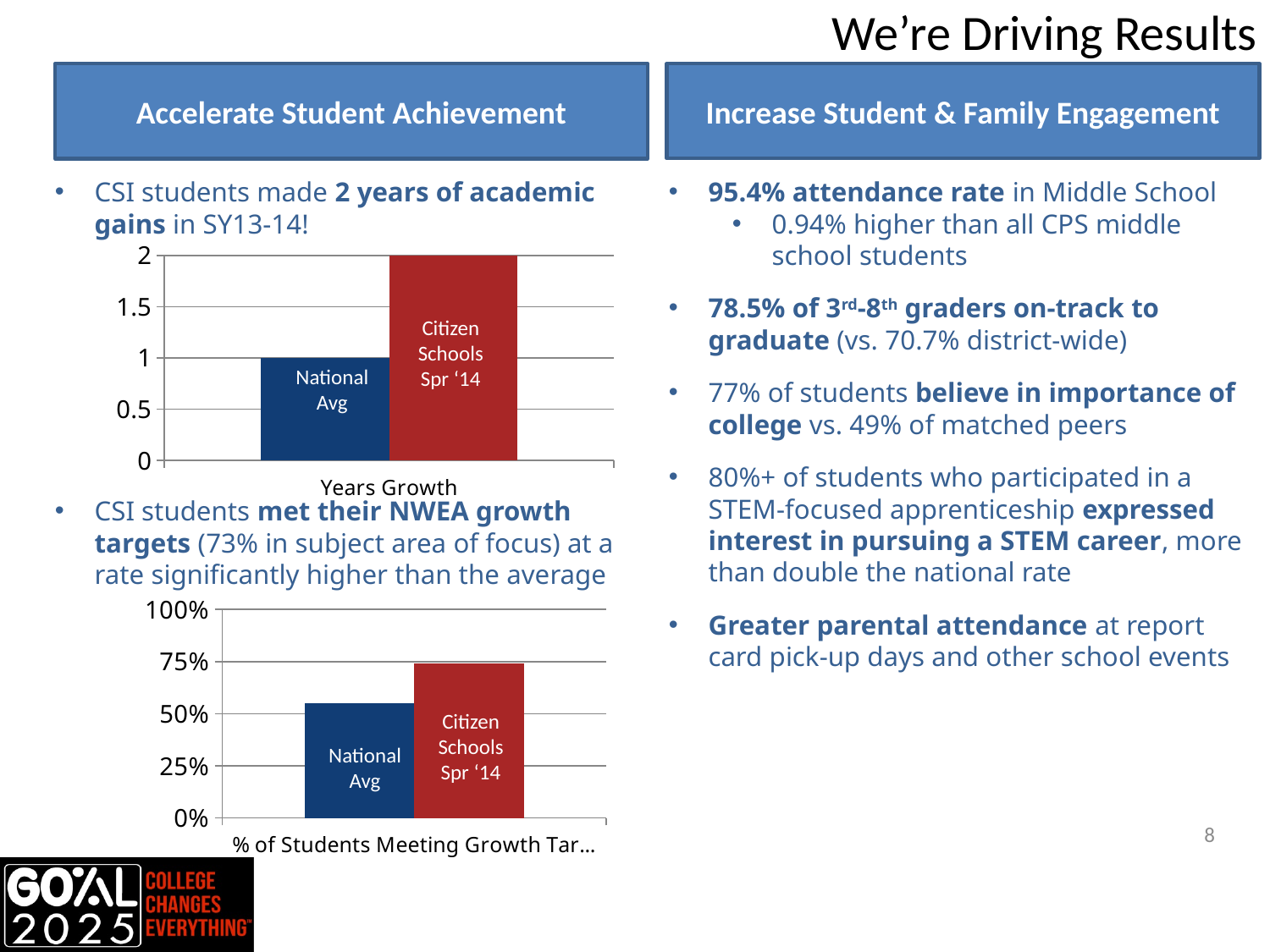
In the % of Students Meeting Growth Targets chart, is the value for Citizen Schools Spr '14 greater or less than 50%? greater In the Years Growth chart, which bar is lowest? National Avg What kind of chart is the Years Growth chart? bar chart In the % of Students Meeting Growth Targets chart, which bar is higher, National Avg or Citizen Schools Spr '14? Citizen Schools Spr '14 In the Years Growth chart, what is the difference between Citizen Schools Spr '14 and National Avg? 1 In the % of Students Meeting Growth Targets chart, what is the highest value shown on the y axis? 100% In the % of Students Meeting Growth Targets chart, is the value for National Avg greater or less than 50%? greater In the Years Growth chart, what is the value for Citizen Schools Spr '14? 2 In the Years Growth chart, what colour is the National Avg bar? blue In the Years Growth chart, what is the value for National Avg? 1 In the Years Growth chart, which bar is highest? Citizen Schools Spr '14 In the Years Growth chart, how many bars are plotted? 2